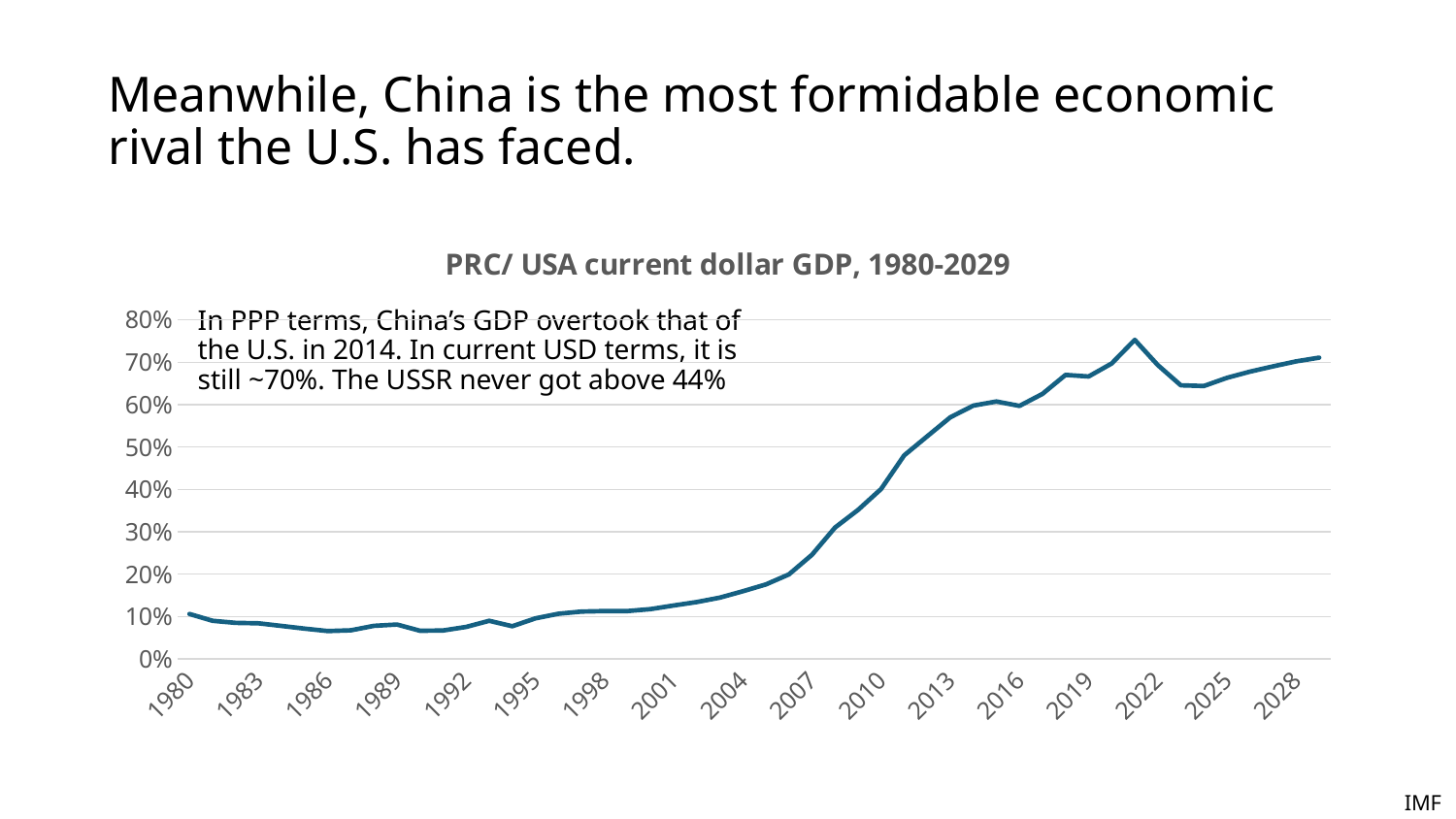
Is the value for 2013 greater or less than 50%? greater Is the value for 1986 greater or less than 10%? less Is the value for 2019 greater or less than 60%? greater What kind of chart is shown on the slide? line chart Overall, does the PRC/USA GDP ratio rise or fall from 1980 to 2029? rise How many year labels are shown on the x axis? 17 What is the highest value shown on the y axis? 80% Does the line rise or fall between 2007 and 2013? rise What is the title of the chart? PRC/ USA current dollar GDP, 1980-2029 What is the source cited for the chart? IMF